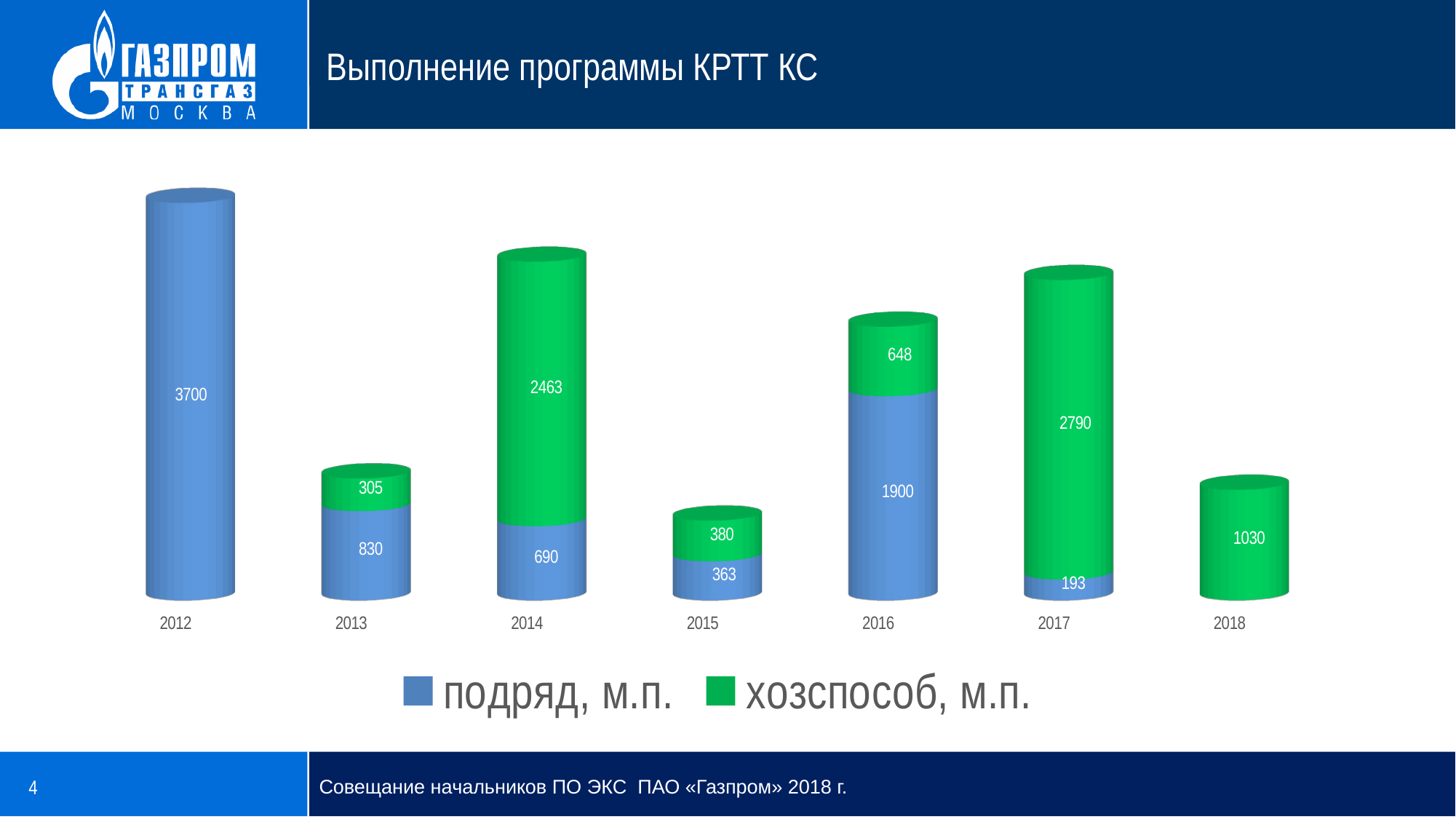
What type of chart is shown on the slide? bar chart What is the value of хозспособ, м.п. for 2017? 2790 Which year has the lowest value for подряд, м.п. among the years where it is shown? 2017 What is the value of подряд, м.п. for 2012? 3700 What is the value of подряд, м.п. for 2016? 1900 How many series does the legend list? 2 Which year has the highest value for хозспособ, м.п.? 2017 Which is larger: подряд, м.п. in 2013 or подряд, м.п. in 2015? подряд, м.п. in 2013 What is the value of хозспособ, м.п. for 2018? 1030 What is the total of the stacked bar for 2014? 3153 What is the difference between хозспособ, м.п. in 2014 and in 2016? 1815 How many years are shown on the x axis? 7